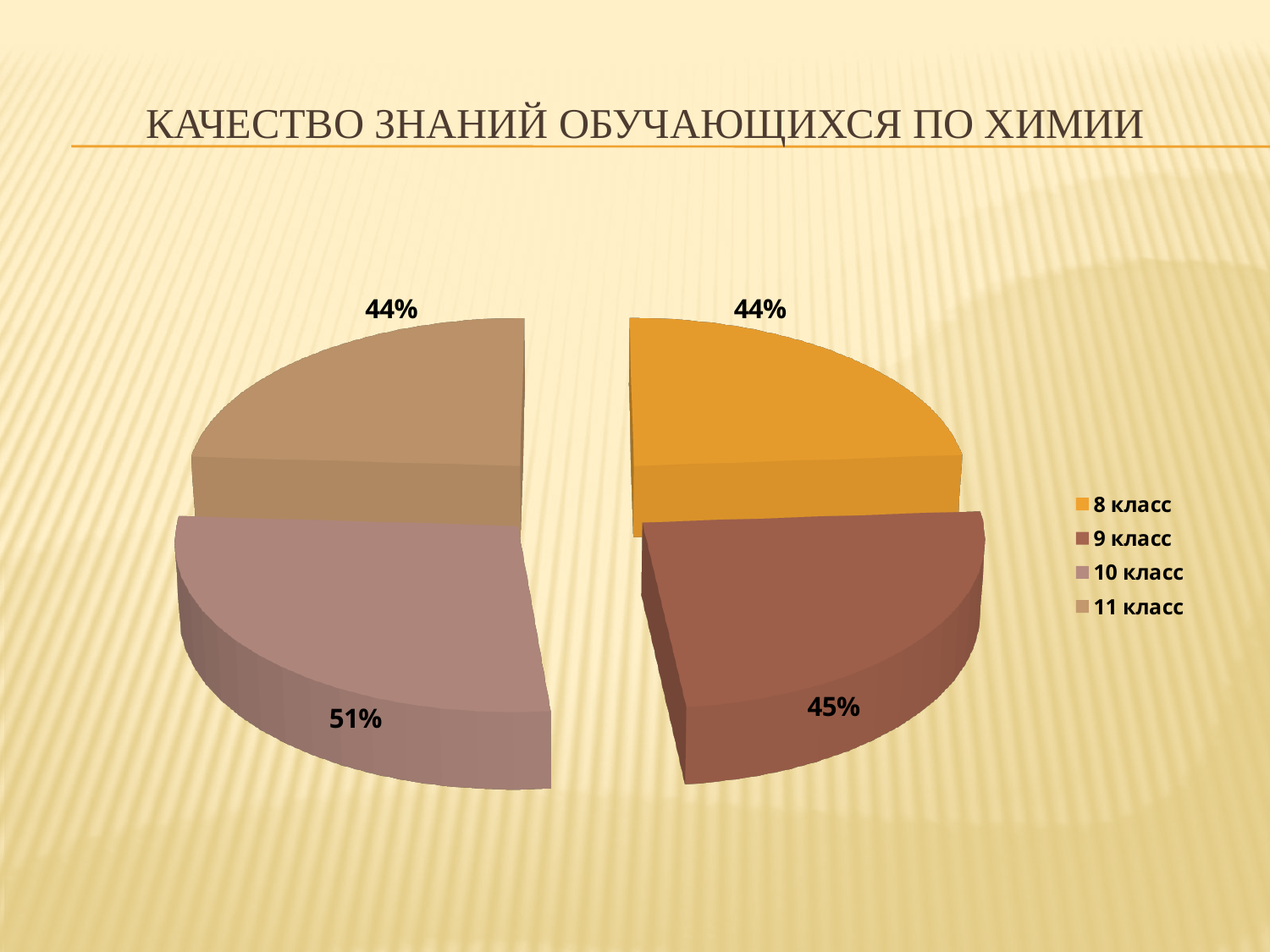
What value is shown for 8 класс? 44% Which is larger, the value for 9 класс or the value for 10 класс? 10 класс What value is shown for 10 класс? 51% What value is shown for 9 класс? 45% What is the difference between the values for 10 класс and 9 класс? 6 percentage points What is the title of the slide? Качество знаний обучающихся по химии Which class has the highest value on the chart? 10 класс What kind of chart is shown on the slide? Pie chart How many slices does the pie chart have? 4 Which legend entry is shown in orange? 8 класс What value is shown for 11 класс? 44% Which classes share the lowest value on the chart? 8 класс and 11 класс